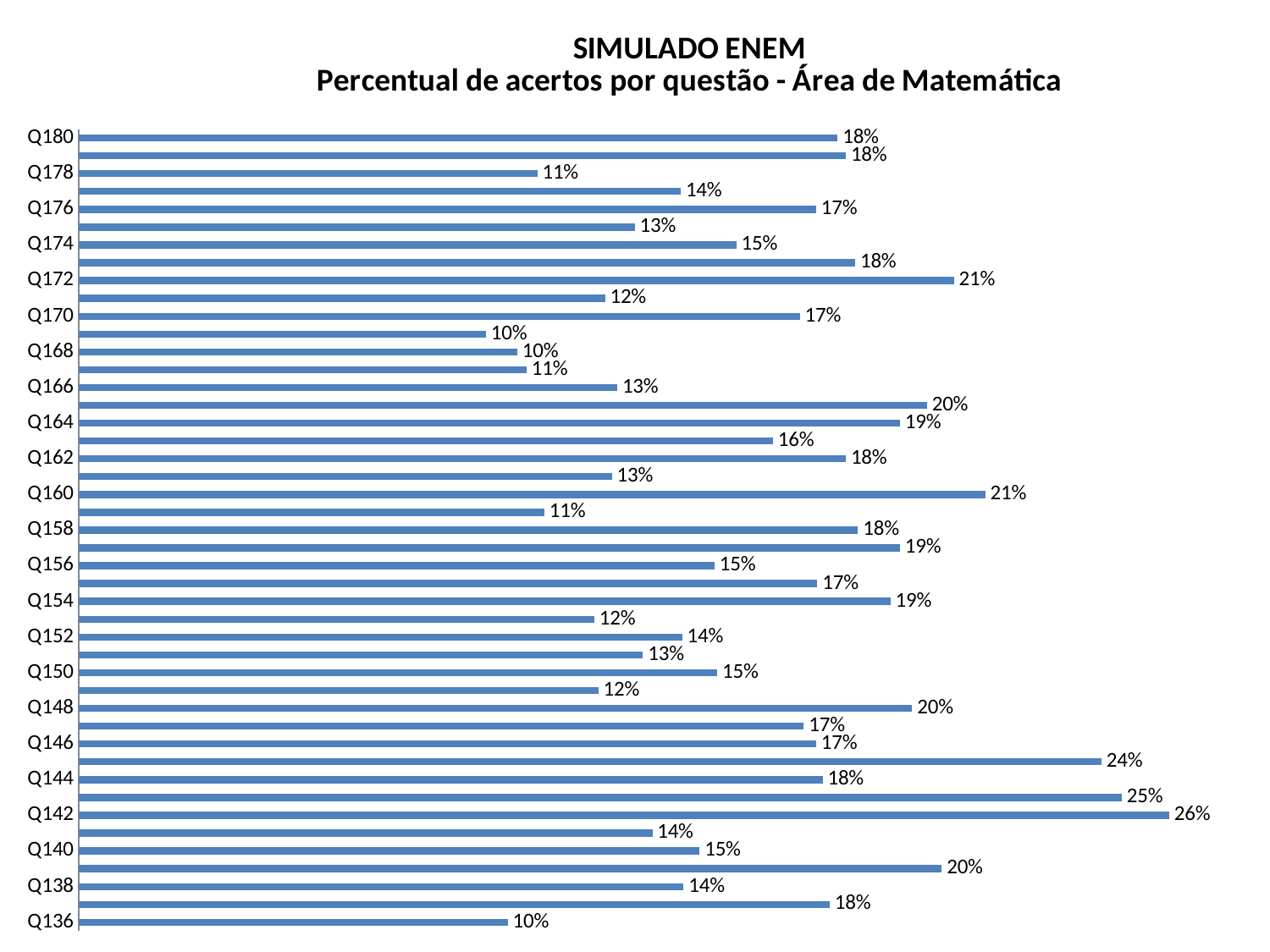
What is the percentage of correct answers for Q142? 26% What is the difference between the percentages for Q142 and Q136? 16% What type of chart is shown on the slide? bar chart Which has a higher percentage of correct answers, Q168 or Q176? Q176 What is the percentage of correct answers for Q172? 21% Which labeled question has the highest percentage of correct answers? Q142 What is the percentage of correct answers for Q164? 19% What is the title of the chart? SIMULADO ENEM Percentual de acertos por questão - Área de Matemática What is the lowest percentage of correct answers shown on the chart? 10% What is the percentage of correct answers for Q136? 10% What is the difference between the percentages for Q160 and Q178? 10% Which has a higher percentage of correct answers, Q148 or Q152? Q148